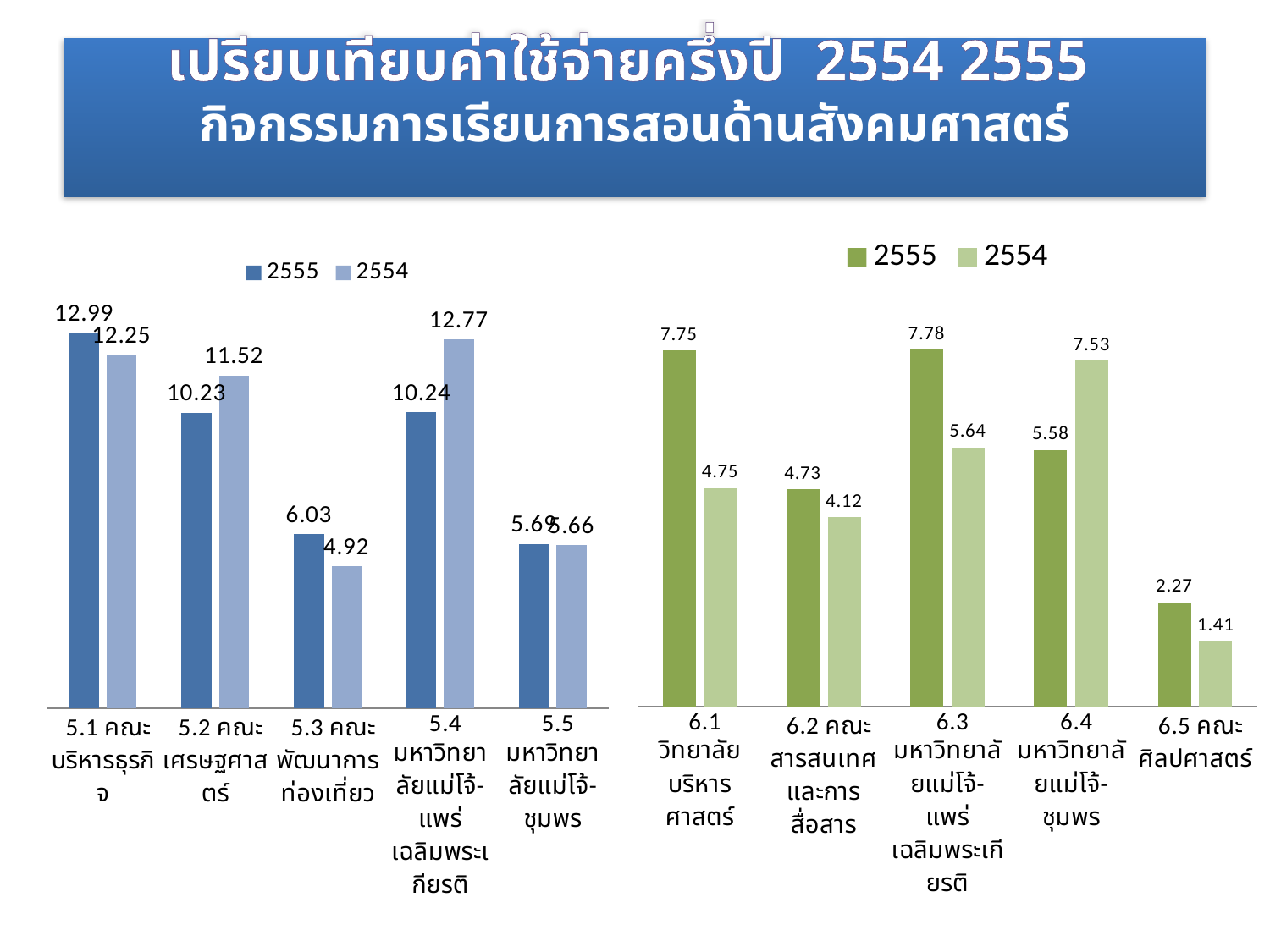
In the right chart, which category has the lowest 2554 value? 6.5 คณะศิลปศาสตร์ In the left chart, what is the difference between the 2554 and 2555 values for 5.2 คณะเศรษฐศาสตร์? 1.29 In the left chart, what is the 2555 value for 5.1 คณะบริหารธุรกิจ? 12.99 In the right chart, what is the 2554 value for 6.4 มหาวิทยาลัยแม่โจ้-ชุมพร? 7.53 In the left chart, what is the 2554 value for 5.4 มหาวิทยาลัยแม่โจ้-แพร่ เฉลิมพระเกียรติ? 12.77 In the left chart, for 5.3 คณะพัฒนาการท่องเที่ยว, which year has the larger value, 2555 or 2554? 2555 How many series does the legend of the left chart list? 2 In the right chart, what is the difference between the 2555 and 2554 values for 6.1 วิทยาลัยบริหารศาสตร์? 3.00 How many categories are shown in the right chart? 5 In the right chart, what is the 2555 value for 6.1 วิทยาลัยบริหารศาสตร์? 7.75 In the left chart, which category has the highest 2555 value? 5.1 คณะบริหารธุรกิจ In the right chart, for 6.4 มหาวิทยาลัยแม่โจ้-ชุมพร, which year has the larger value, 2555 or 2554? 2554